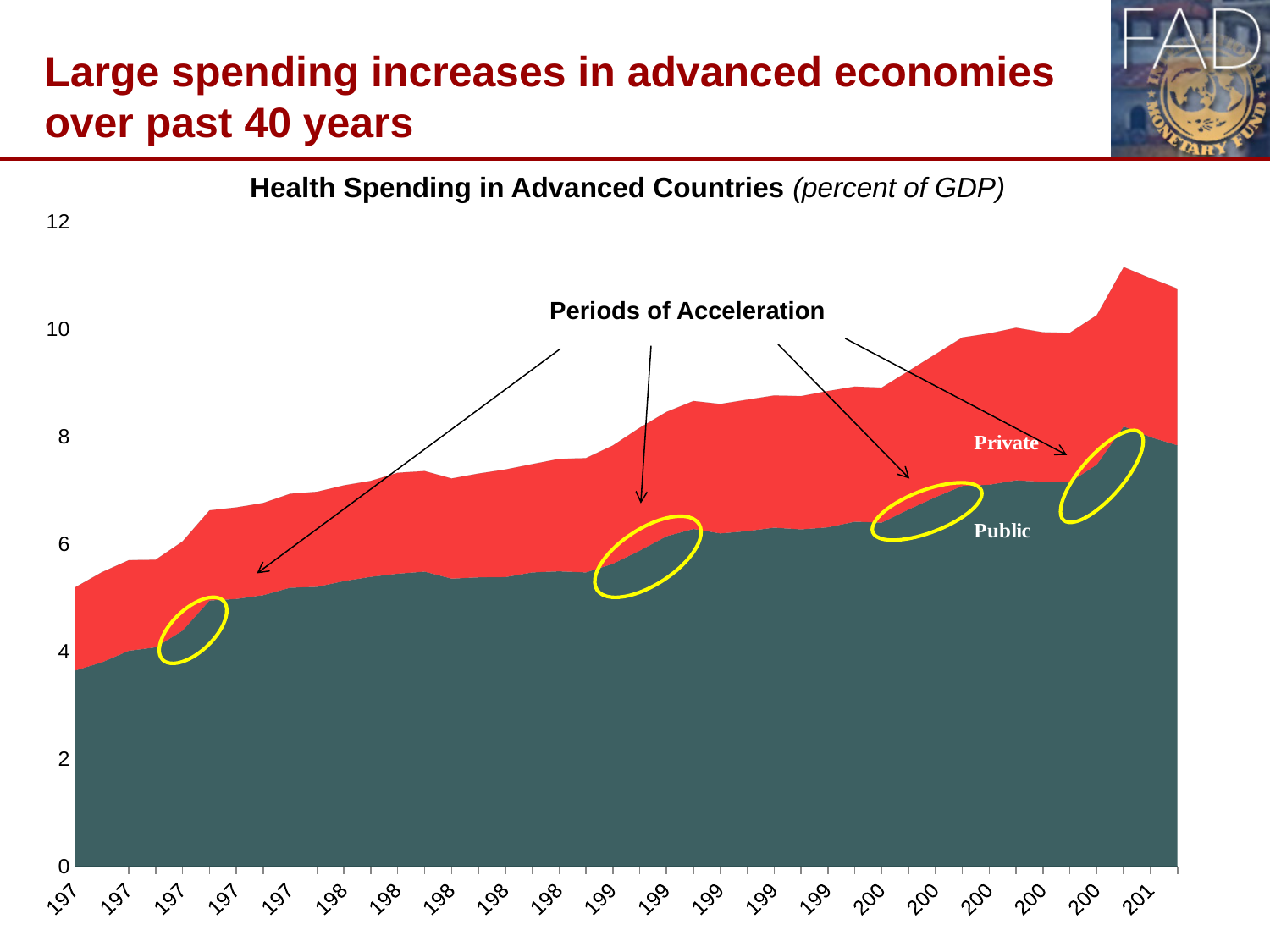
Is the highest total health spending reached on the chart greater or less than 10? greater Does Public health spending generally rise or fall over the period shown? Rise What is the title of the chart? Health Spending in Advanced Countries (percent of GDP) Is the Public spending at the leftmost point greater or less than 4? less How many periods of acceleration are circled on the chart? 4 How many series does the chart show? 2 Is the Public spending at the rightmost point greater or less than 6? greater What kind of chart is shown on the slide? Stacked area chart Does total health spending generally rise or fall from left to right along the x axis? Rise What are the two series labelled in the chart? Private and Public At the rightmost point, which series is larger, Public or Private? Public